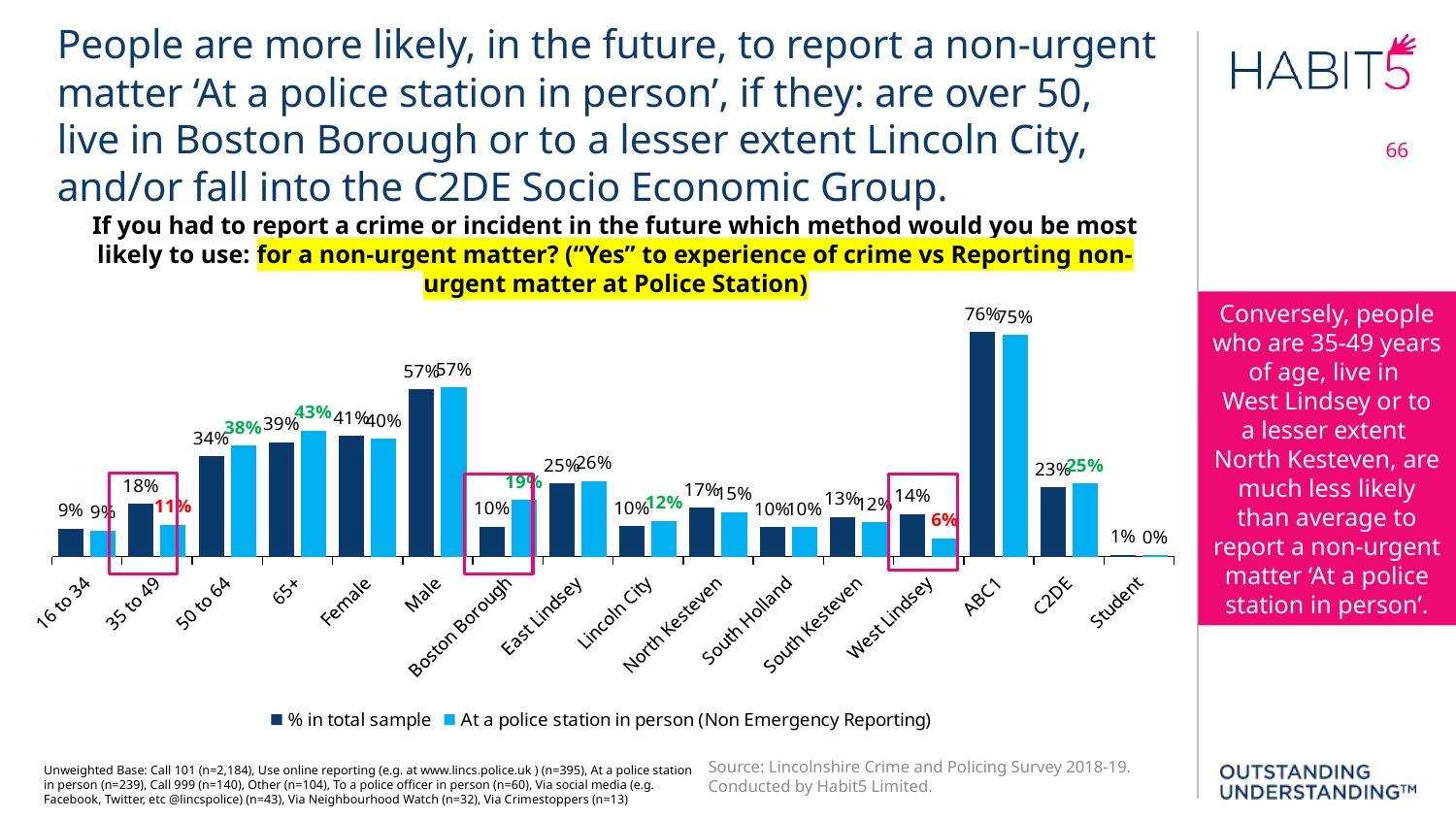
What is the difference between the '% in total sample' value and the 'At a police station in person' value for West Lindsey? 8% How many series does the chart legend list? 2 What is the '% in total sample' value for 35 to 49? 18% What is the '% in total sample' value for ABC1? 76% What is the 'At a police station in person (Non Emergency Reporting)' value for West Lindsey? 6% Which category has the lowest 'At a police station in person (Non Emergency Reporting)' value? Student What kind of chart is shown on the slide? Bar chart How many categories are shown on the x axis of the chart? 16 For 65+, which is larger: '% in total sample' or 'At a police station in person (Non Emergency Reporting)'? At a police station in person (Non Emergency Reporting) Which category has the highest 'At a police station in person (Non Emergency Reporting)' value? ABC1 What is the difference between the 'At a police station in person' value and the '% in total sample' value for Boston Borough? 9% What is the value for 'At a police station in person (Non Emergency Reporting)' for Boston Borough? 19%